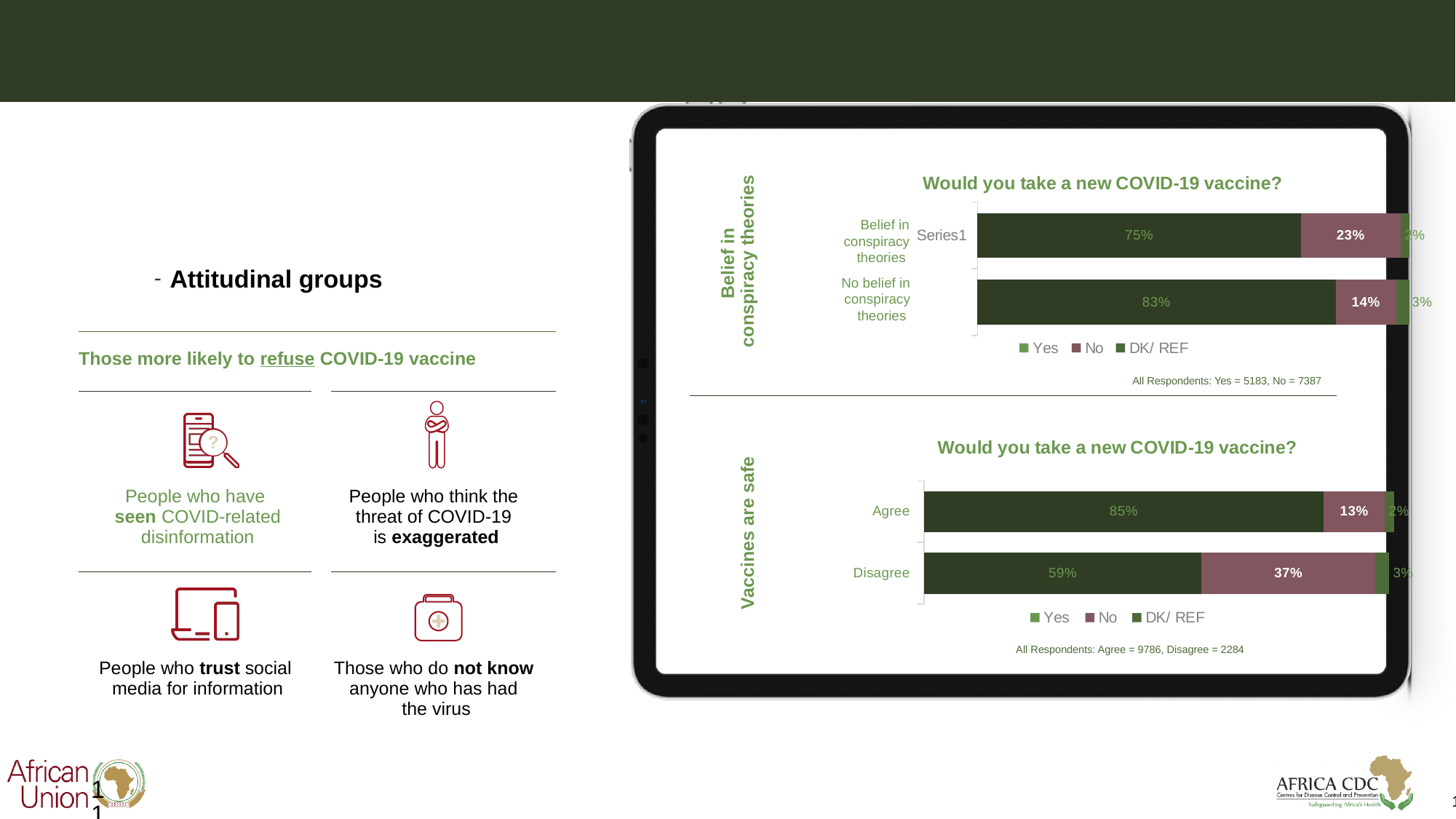
In the bottom chart (Vaccines are safe), what percentage of those who Agree answered Yes? 85% In the top chart (Belief in conspiracy theories), which group has the higher No percentage? Belief in conspiracy theories In the top chart (Belief in conspiracy theories), what is the difference between the Yes percentages for the two groups? 8% In the bottom chart (Vaccines are safe), which group has the higher Yes percentage, Agree or Disagree? Agree What is the title of the top chart on the slide? Would you take a new COVID-19 vaccine? What kind of chart is the bottom chart (Vaccines are safe)? Stacked bar chart In the top chart (Belief in conspiracy theories), what percentage of people with belief in conspiracy theories answered Yes? 75% How many series does the legend of the bottom chart (Vaccines are safe) list? 3 In the top chart (Belief in conspiracy theories), what percentage of people with no belief in conspiracy theories answered No? 14% In the bottom chart (Vaccines are safe), what percentage of those who Disagree answered No? 37% In the bottom chart (Vaccines are safe), what is the difference between the No percentages for Disagree and Agree? 24% How many categories are shown in the top chart (Belief in conspiracy theories)? 2